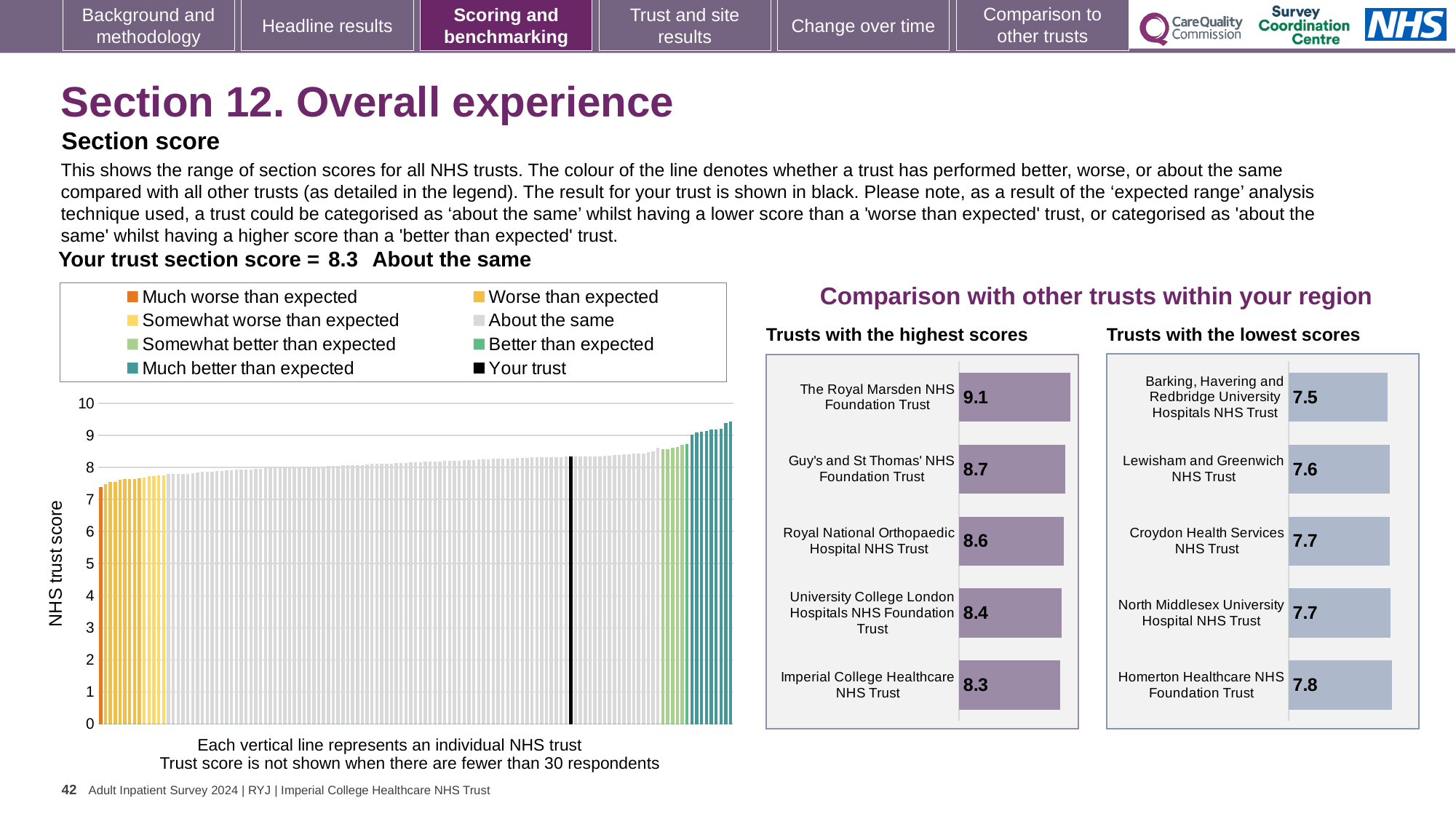
What kind of chart is the large chart on the left showing NHS trust scores? Bar chart How many entries does the legend of the large chart on the left list? 8 In the 'Trusts with the lowest scores' chart, what is the score for Barking, Havering and Redbridge University Hospitals NHS Trust? 7.5 In the 'Trusts with the highest scores' chart, which trust has the lowest score shown? Imperial College Healthcare NHS Trust In the large chart on the left, do the trust scores rise or fall from left to right? Rise In the large chart on the left, what is the section score for your trust (the black bar)? 8.3 How many trusts are shown in the 'Trusts with the highest scores' chart? 5 In the 'Trusts with the lowest scores' chart, what score do Croydon Health Services NHS Trust and North Middlesex University Hospital NHS Trust both have? 7.7 In the 'Trusts with the lowest scores' chart, which trust has the highest score shown? Homerton Healthcare NHS Foundation Trust In the 'Trusts with the highest scores' chart, what is the score for The Royal Marsden NHS Foundation Trust? 9.1 In the 'Trusts with the lowest scores' chart, which has the higher score: Lewisham and Greenwich NHS Trust or Homerton Healthcare NHS Foundation Trust? Homerton Healthcare NHS Foundation Trust In the 'Trusts with the highest scores' chart, what is the difference between the scores of The Royal Marsden NHS Foundation Trust and Imperial College Healthcare NHS Trust? 0.8